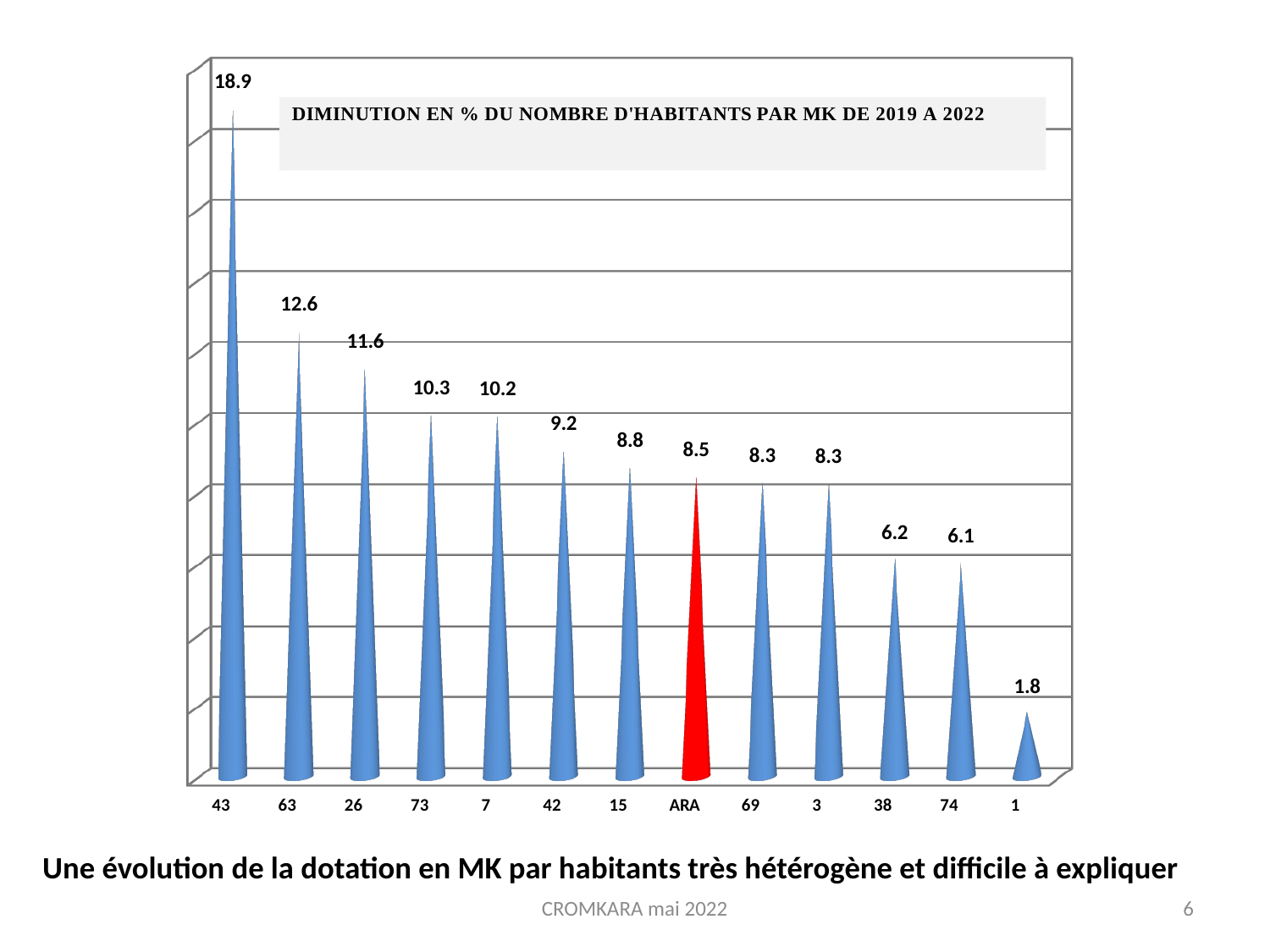
What is the difference between the values for ARA and category 1? 6.7 Which category has the lowest value? 1 What is the value for category 43? 18.9 How many categories are shown on the x axis? 13 What kind of chart is this? bar chart What is the value for category 38? 6.2 Which category has the highest value? 43 Which category's bar is coloured red? ARA What is the value for ARA? 8.5 Do the values rise or fall from left to right along the x axis? fall What is the difference between the values for category 43 and category 63? 6.3 Which is larger, the value for category 26 or the value for category 42? 26